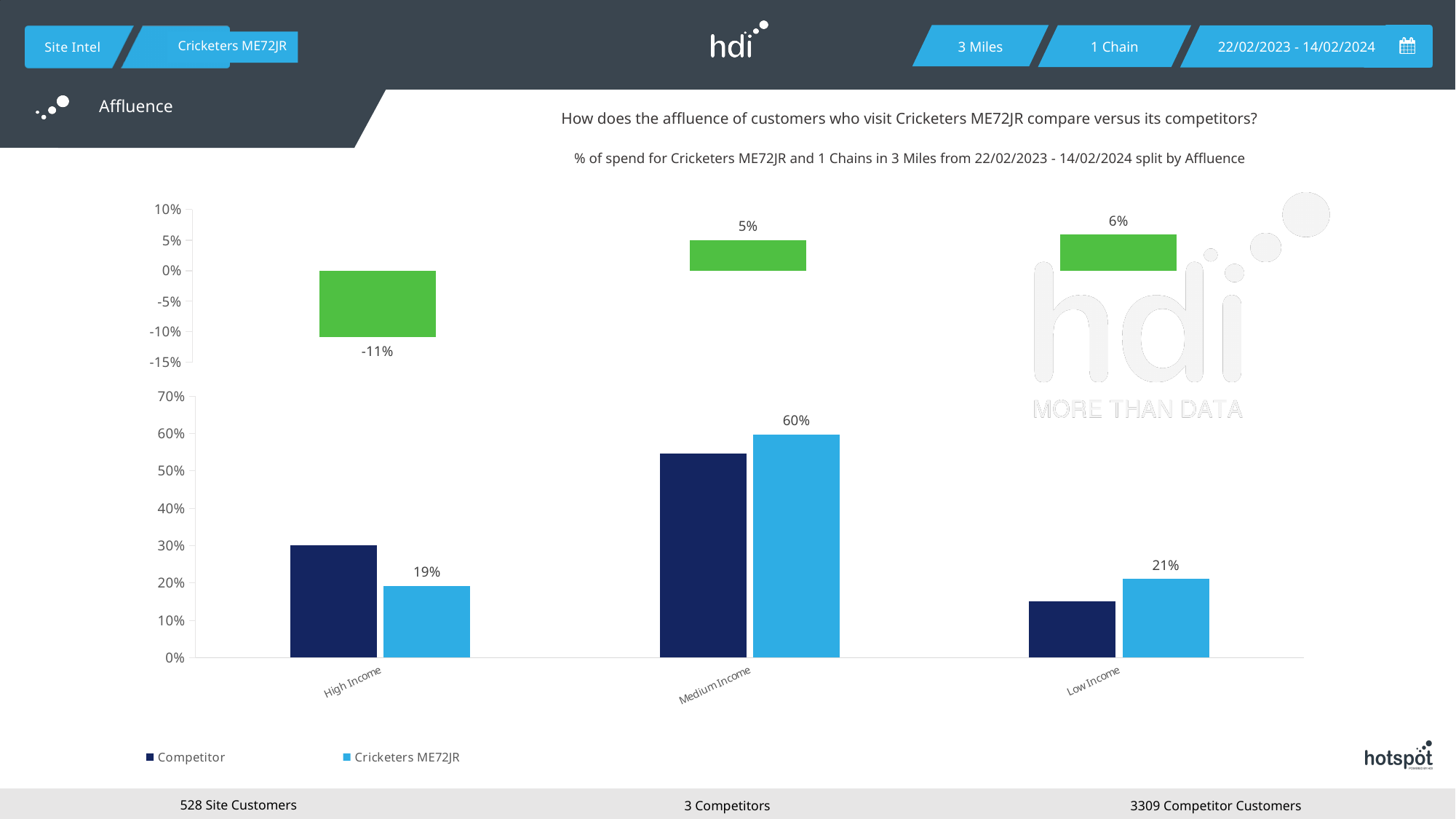
In the bottom chart, which is larger for High Income: Competitor or Cricketers ME72JR? Competitor In the bottom chart, what is the difference between the Cricketers ME72JR values for Medium Income and High Income? 41% In the bottom chart, which category has the highest value for Cricketers ME72JR? Medium Income In the bottom chart, is the Competitor value for Low Income greater or less than 20%? less In the top chart, what is the value shown for High Income? -11% In the bottom chart, what is the value for Cricketers ME72JR in the Medium Income category? 60% In the bottom chart, what is the value for Cricketers ME72JR in the High Income category? 19% In the top chart, which category has the lowest value? High Income In the bottom chart, is the Competitor value for Medium Income greater or less than 50%? greater In the top chart, what is the value shown for Low Income? 6% How many series does the legend of the bottom chart list? 2 In the bottom chart, what is the value for Cricketers ME72JR in the Low Income category? 21%